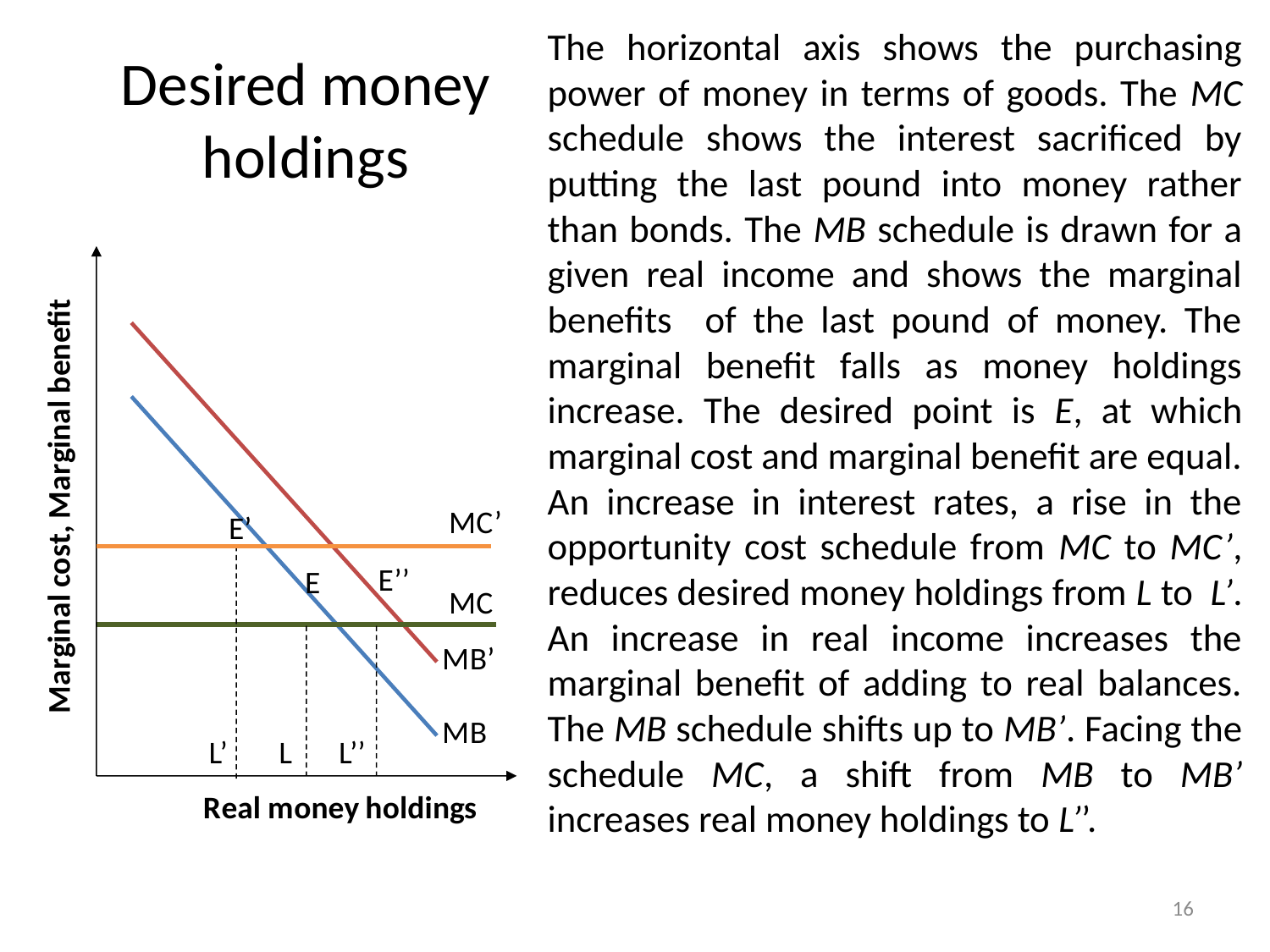
How many equilibrium points (E, E', E'') are marked on the chart? 3 Of the money holdings L, L' and L'', which is the smallest on the horizontal axis? L' Of the money holdings L, L' and L'', which is the largest on the horizontal axis? L'' How many schedules (lines) are drawn on the chart? 4 Does the MB schedule rise or fall as real money holdings increase? Fall Which is higher on the chart, the MC schedule or the MC' schedule? MC' Which point on the chart lies at the intersection of MB' and MC? E'' Which is higher on the chart, the MB schedule or the MB' schedule? MB' What is the label of the horizontal axis of the chart? Real money holdings Which point on the chart lies at the intersection of MB and MC'? E' What is the title of the chart on the slide? Desired money holdings What kind of chart is shown on the slide? Line chart